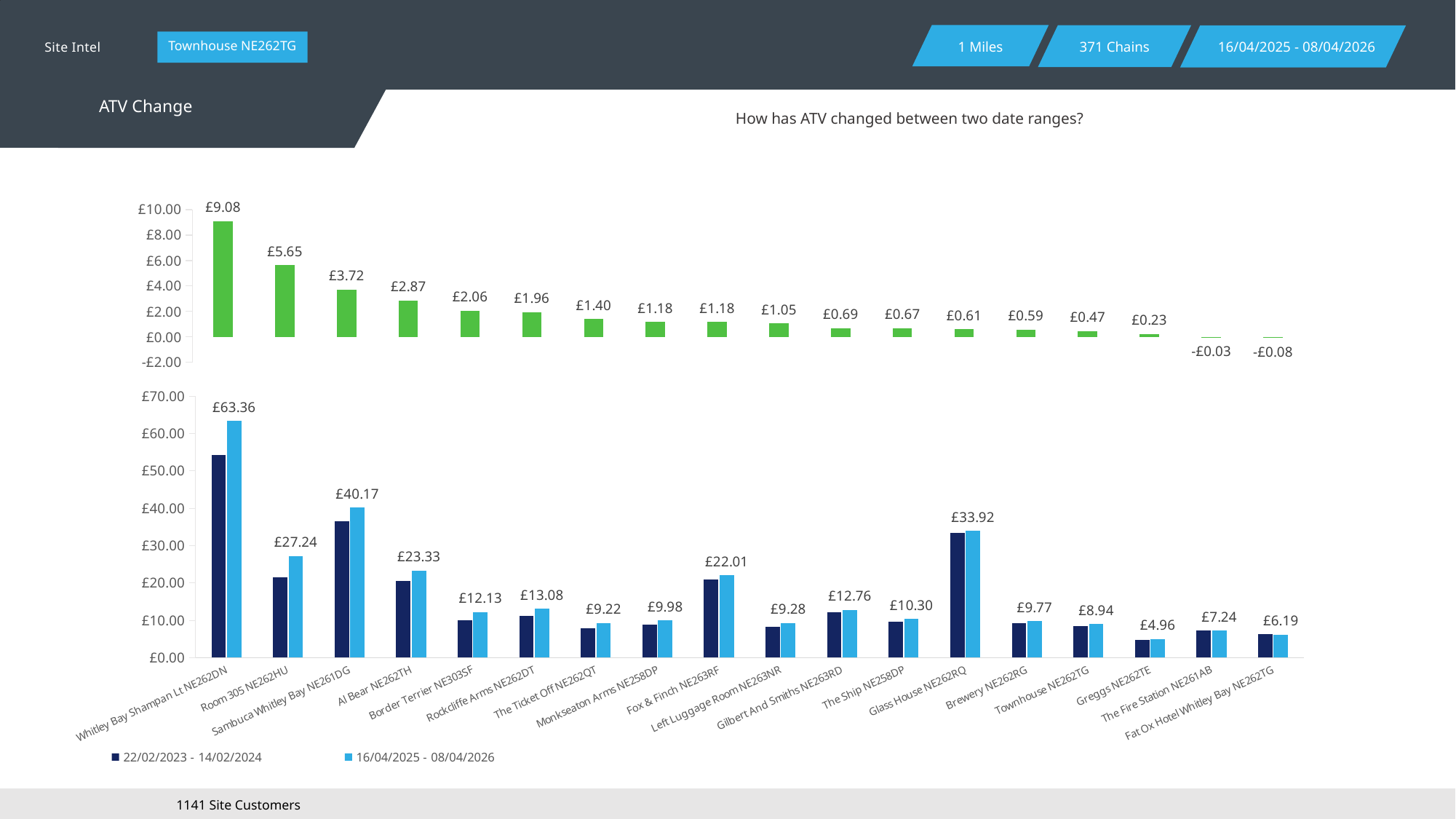
In the bottom chart, which venue has the lowest value in the 16/04/2025 - 08/04/2026 series? Greggs NE262TE How many series does the legend of the bottom chart list? 2 In the bottom chart, what is the difference between the 16/04/2025 - 08/04/2026 values for Sambuca Whitley Bay NE261DG and Glass House NE262RQ? £6.25 In the bottom chart, is the 22/02/2023 - 14/02/2024 value for Whitley Bay Shampan Lt NE262DN greater or less than £50.00? greater In the bottom chart, which has the larger 16/04/2025 - 08/04/2026 value: Al Bear NE262TH or Fox & Finch NE263RF? Al Bear NE262TH In the top chart, what is the highest value shown? £9.08 In the bottom chart, which venue has the highest value in the 16/04/2025 - 08/04/2026 series? Whitley Bay Shampan Lt NE262DN How many bars are plotted in the top chart? 18 In the top chart, do the values rise or fall from left to right? fall In the bottom chart, what is the value for Whitley Bay Shampan Lt NE262DN in the 16/04/2025 - 08/04/2026 series? £63.36 In the bottom chart, what is the value for Glass House NE262RQ in the 16/04/2025 - 08/04/2026 series? £33.92 In the top chart, what is the lowest value shown? -£0.08